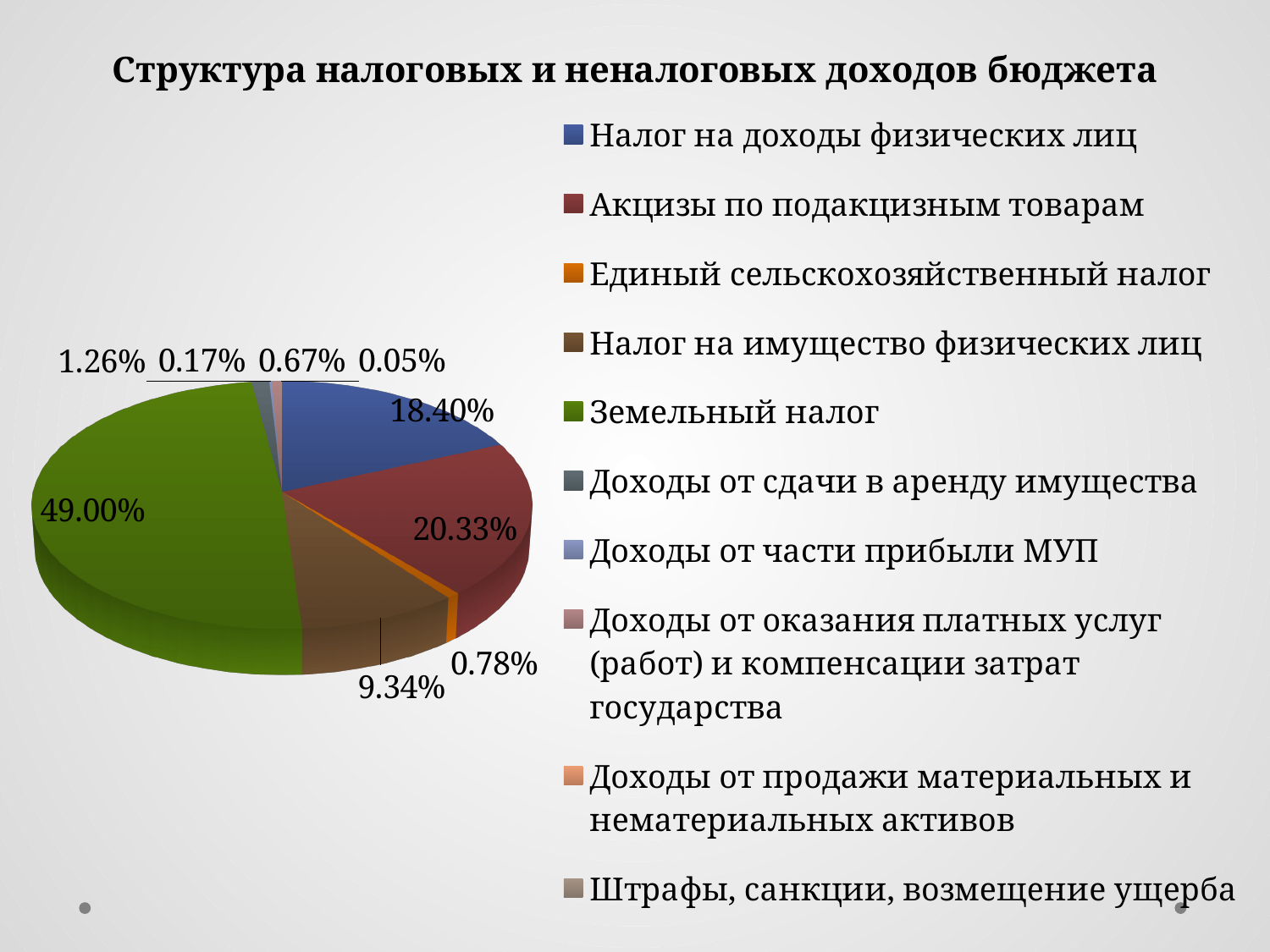
Which is larger: Акцизы по подакцизным товарам or Налог на доходы физических лиц? Акцизы по подакцизным товарам What colour is the slice for Земельный налог? green What share of the pie is Земельный налог? 49.00% Which category has the largest share of the pie? Земельный налог What is the value for Налог на имущество физических лиц? 9.34% What is the value for Налог на доходы физических лиц? 18.40% What is the title of the chart? Структура налоговых и неналоговых доходов бюджета What is the difference between the shares of Акцизы по подакцизным товарам and Налог на доходы физических лиц? 1.93% How many categories does the legend list? 10 What kind of chart is shown on the slide? pie chart What is the value for Акцизы по подакцизным товарам? 20.33% What is the value for Единый сельскохозяйственный налог? 0.78%